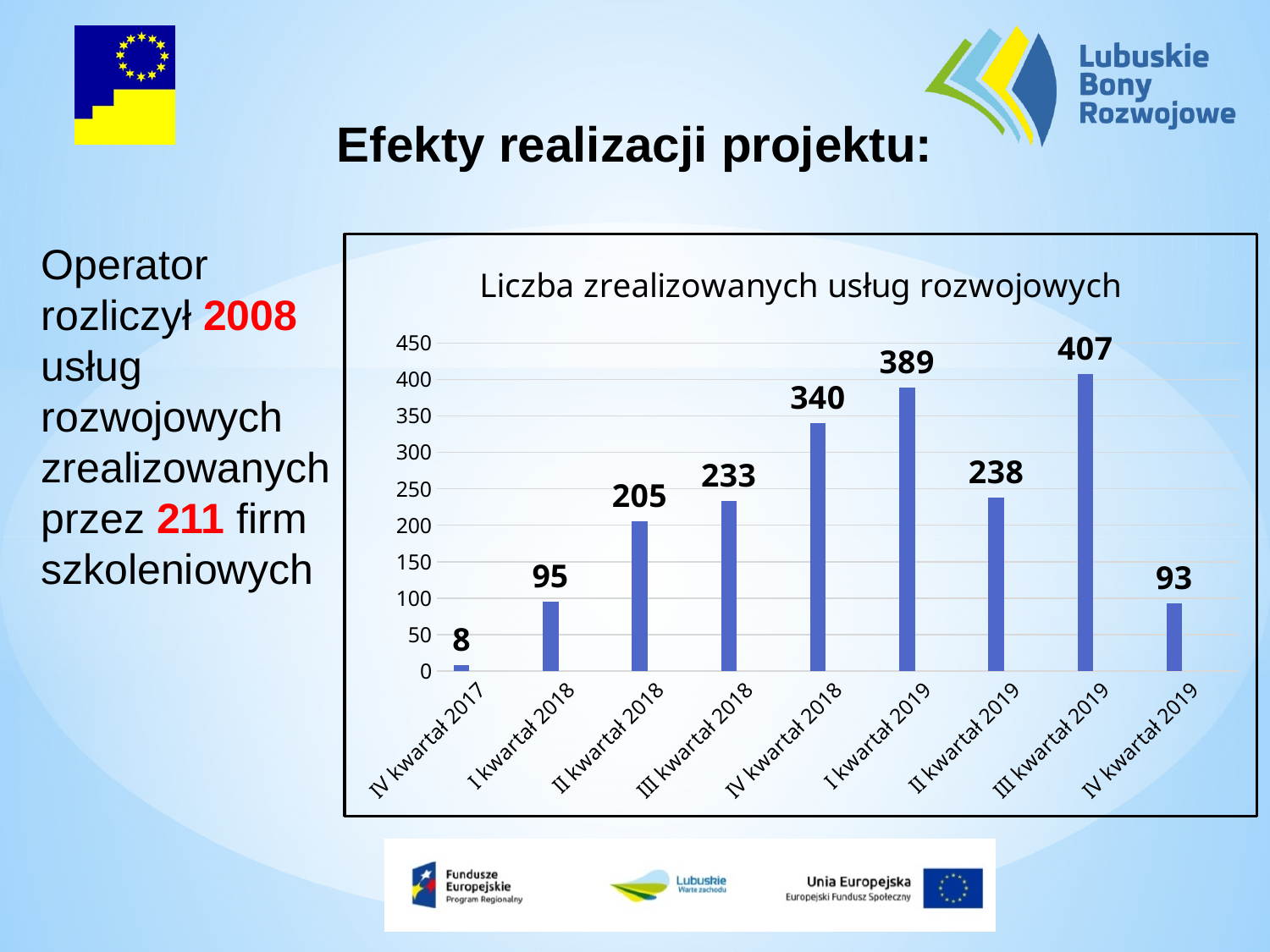
Which quarter has the highest number of realized development services? III kwartał 2019 What is the value for IV kwartał 2017? 8 What is the difference between the values for I kwartał 2019 and IV kwartał 2018? 49 Which quarter has the lowest number of realized development services? IV kwartał 2017 What is the title of the chart? Liczba zrealizowanych usług rozwojowych What is the value for II kwartał 2019? 238 How many quarters are shown on the x axis? 9 What is the value for III kwartał 2019? 407 Is the value for IV kwartał 2019 greater or less than 100? less Do the values rise or fall from IV kwartał 2017 to IV kwartał 2018? rise Which is larger, the value for II kwartał 2018 or the value for III kwartał 2018? III kwartał 2018 What kind of chart is shown on the slide? bar chart